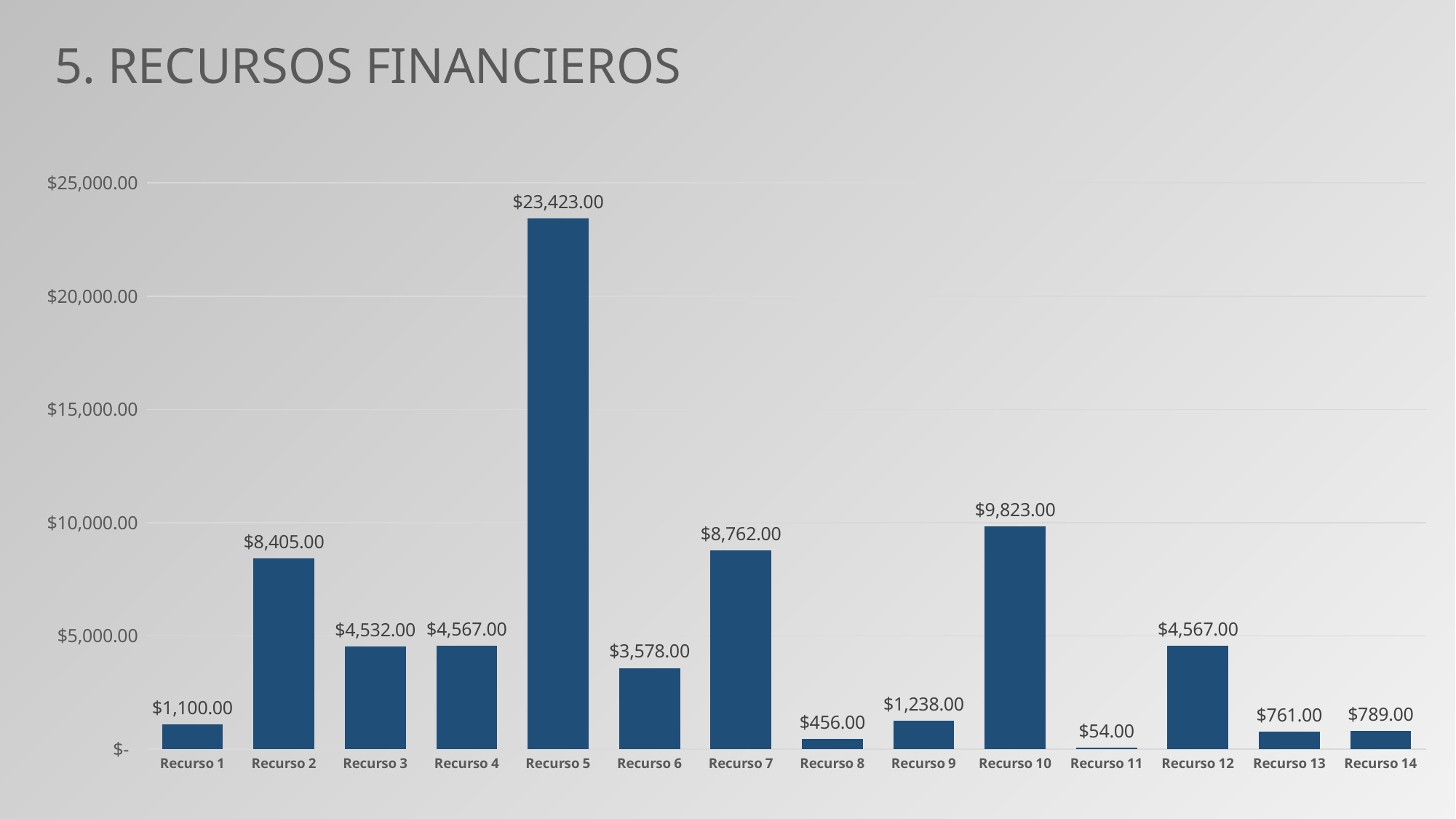
What is the value for Recurso 11? $54.00 Which is larger, the value for Recurso 2 or the value for Recurso 7? Recurso 7 What is the difference between the values for Recurso 10 and Recurso 7? $1,061.00 Which category has the lowest value? Recurso 11 Which category has the highest value? Recurso 5 What is the value for Recurso 10? $9,823.00 What is the title of the slide? 5. RECURSOS FINANCIEROS How many categories are shown on the x axis? 14 What kind of chart is shown on the slide? bar chart What is the value for Recurso 5? $23,423.00 What is the difference between the values for Recurso 2 and Recurso 6? $4,827.00 Is the value for Recurso 10 greater or less than $5,000.00? greater